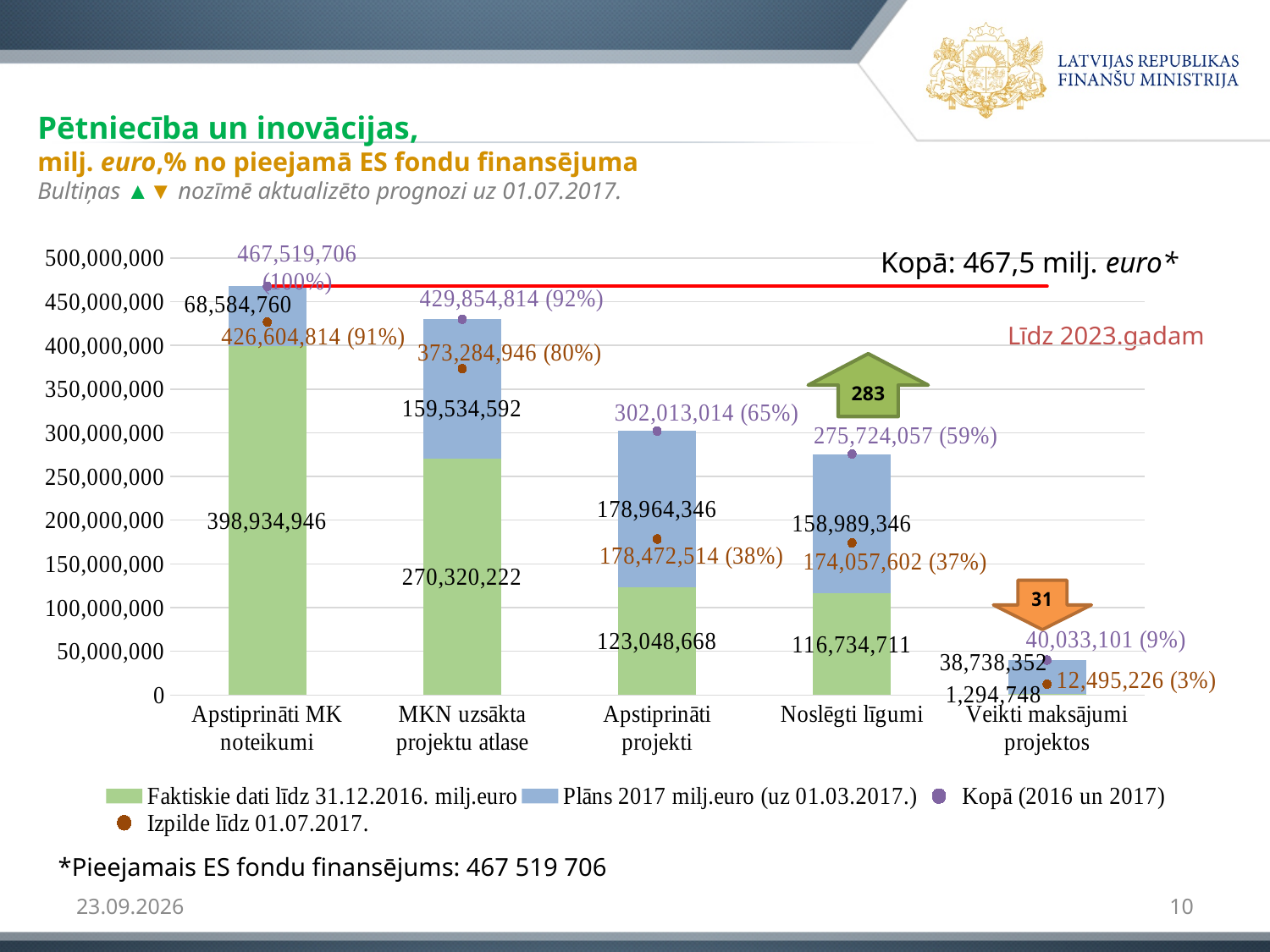
How many series does the legend list? 4 What is the 'Izpilde līdz 01.07.2017.' value shown for 'Apstiprināti projekti'? 178,472,514 (38%) Which category has the highest 'Plāns 2017 milj.euro (uz 01.03.2017.)' value? Apstiprināti projekti What is the total of the stacked bar for 'MKN uzsākta projektu atlase'? 429,854,814 What is the 'Kopā (2016 un 2017)' value shown for 'Noslēgti līgumi'? 275,724,057 (59%) Which category has the lowest 'Faktiskie dati līdz 31.12.2016. milj.euro' value? Veikti maksājumi projektos What kind of chart is this? Stacked bar chart How many categories are shown on the x axis? 5 What is the value of 'Plāns 2017 milj.euro (uz 01.03.2017.)' for 'MKN uzsākta projektu atlase'? 159,534,592 What is the value of 'Faktiskie dati līdz 31.12.2016. milj.euro' for 'Apstiprināti MK noteikumi'? 398,934,946 Which is larger: the 'Plāns 2017 milj.euro (uz 01.03.2017.)' value for 'Apstiprināti projekti' or for 'Noslēgti līgumi'? Apstiprināti projekti What is the difference between the 'Faktiskie dati līdz 31.12.2016. milj.euro' values for 'Apstiprināti MK noteikumi' and 'MKN uzsākta projektu atlase'? 128,614,724